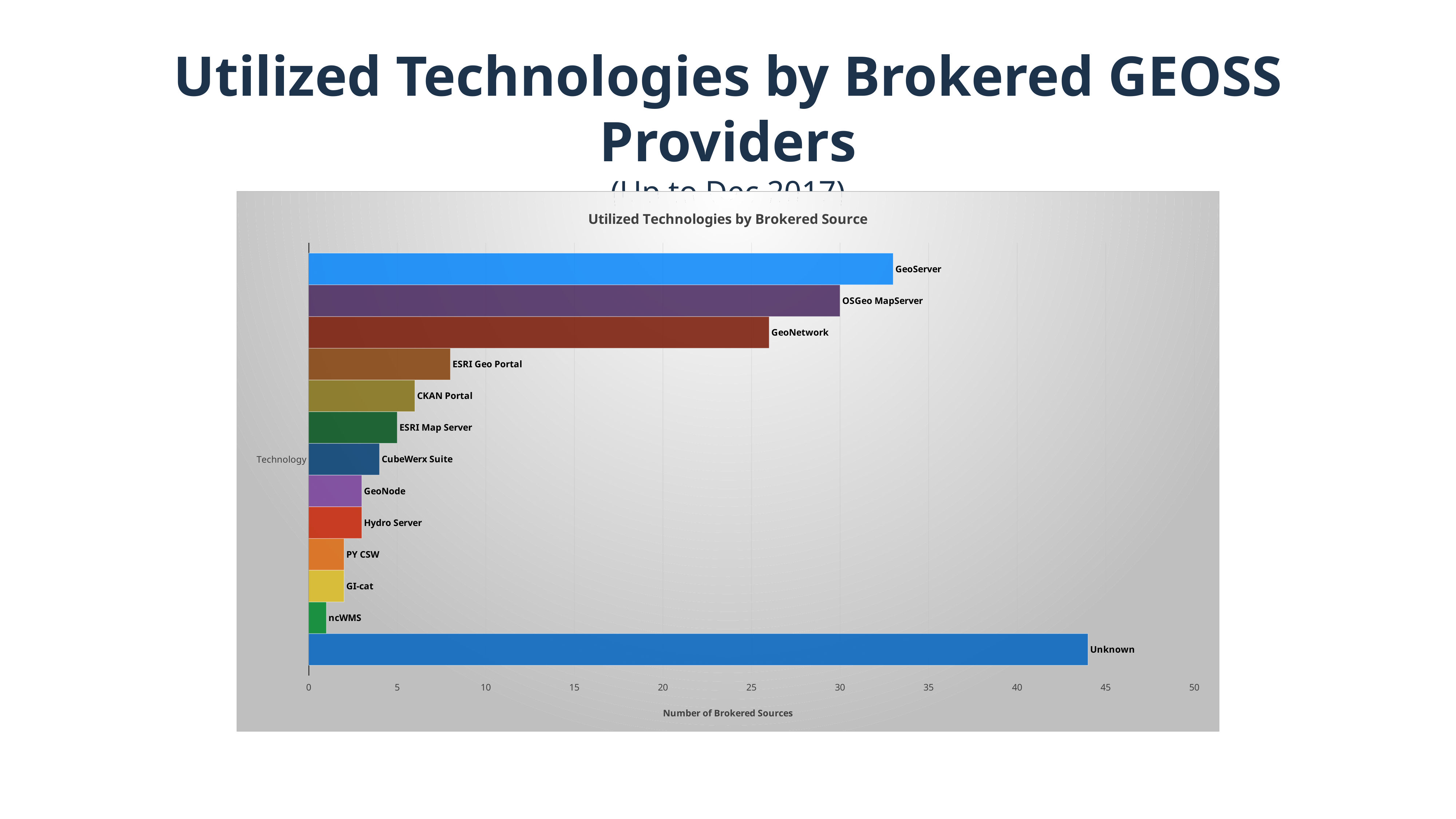
Which technology has the highest number of brokered sources? Unknown Which technology has the lowest number of brokered sources? ncWMS What is the label of the horizontal axis? Number of Brokered Sources How many technologies (bars) are plotted in the chart? 13 Is the value for Unknown greater or less than 40? greater What kind of chart is shown on the slide? bar chart Is the value for GeoServer greater or less than 30? greater Which has more brokered sources, ESRI Geo Portal or CKAN Portal? ESRI Geo Portal Is the value for GeoNetwork greater or less than 30? less Which has more brokered sources, GeoServer or GeoNetwork? GeoServer What is the title printed inside the chart area? Utilized Technologies by Brokered Source